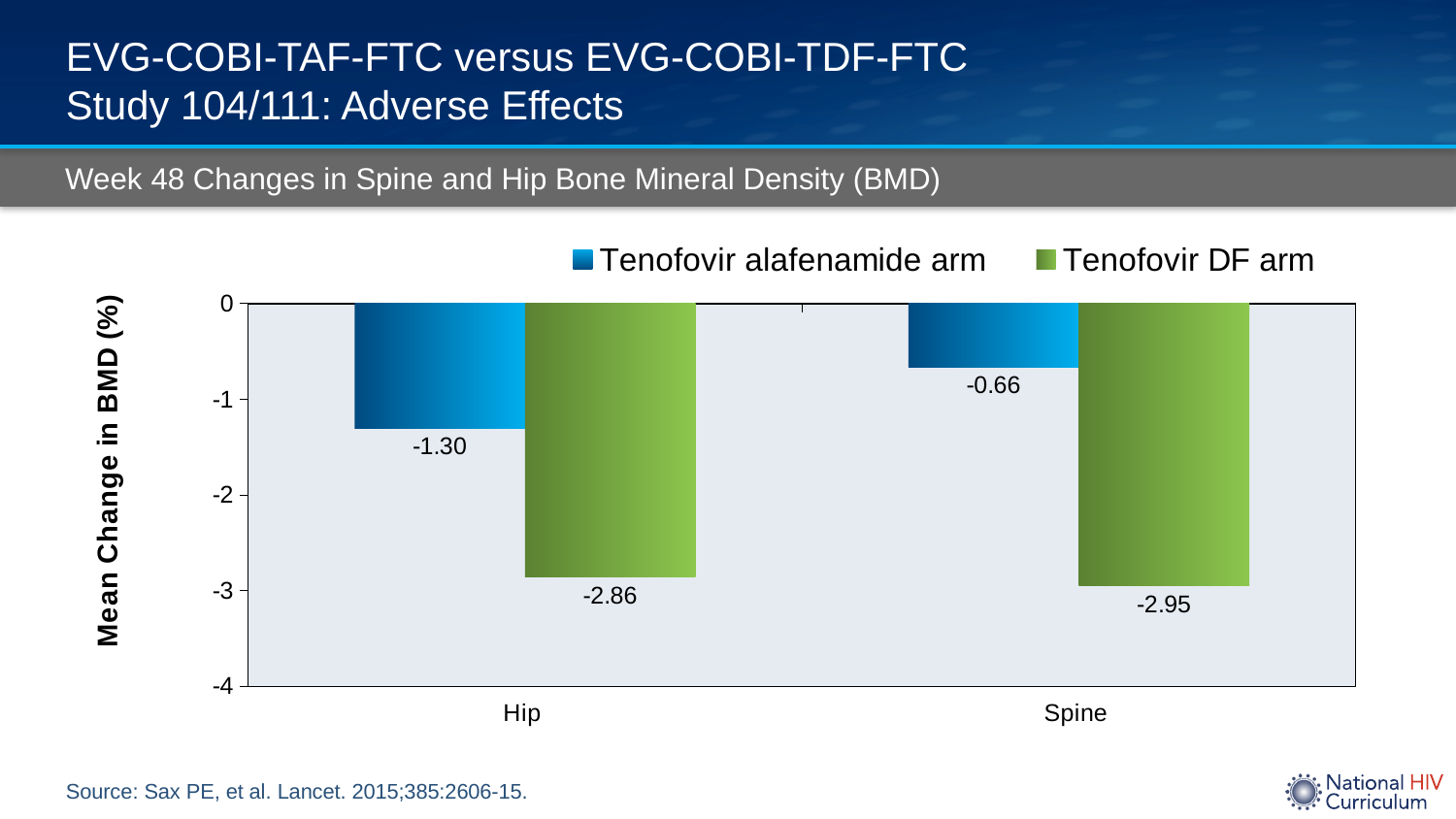
What is the difference between the Tenofovir DF arm and the Tenofovir alafenamide arm at the Spine? 2.29 What is the mean change in BMD for the Tenofovir DF arm at the Hip? -2.86 What is the difference between the Tenofovir DF arm and the Tenofovir alafenamide arm at the Hip? 1.56 At the Spine, which arm has the larger decrease in BMD? Tenofovir DF arm How many categories are shown on the x axis? 2 Which bar shows the smallest decrease in BMD? Tenofovir alafenamide arm, Spine Which bar shows the largest decrease in BMD? Tenofovir DF arm, Spine What kind of chart is shown on the slide? Bar chart What is the mean change in BMD for the Tenofovir alafenamide arm at the Hip? -1.30 What is the mean change in BMD for the Tenofovir DF arm at the Spine? -2.95 What is the mean change in BMD for the Tenofovir alafenamide arm at the Spine? -0.66 How many series does the legend list? 2